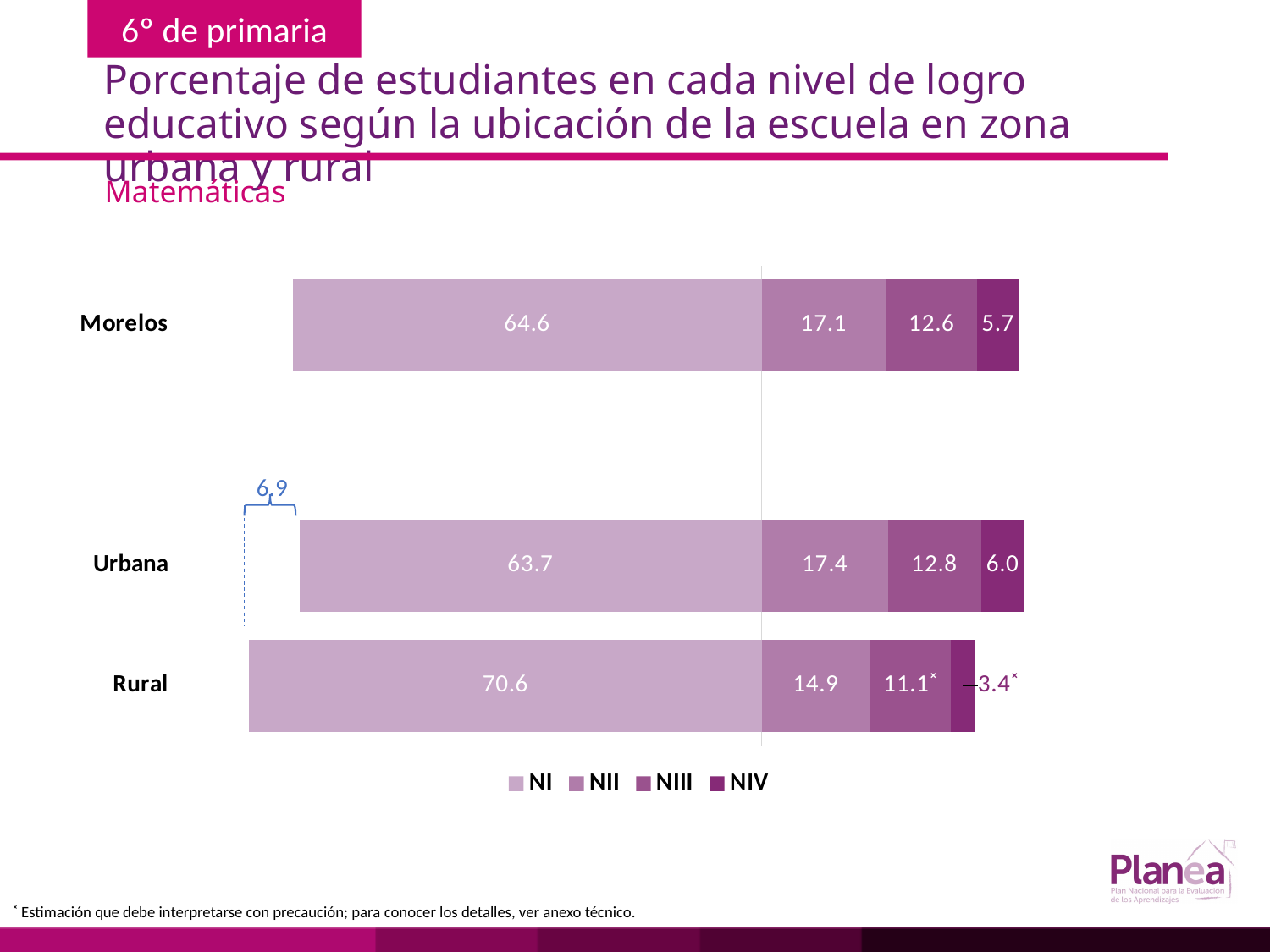
What is the NIII value for Rural? 11.1 What is the NII value for Morelos? 17.1 What is the difference between the NI values for Rural and Urbana? 6.9 How many categories are shown on the chart? 3 How many series does the legend list? 4 Which category has the highest NI value? Rural Which is larger, the NII value for Urbana or the NII value for Rural? Urbana Which category has the lowest NIV value? Rural What is the NI value for Rural? 70.6 What is the total of the stacked bar for Morelos? 100.0 What kind of chart is shown on the slide? Stacked bar chart What is the NIV value for Urbana? 6.0